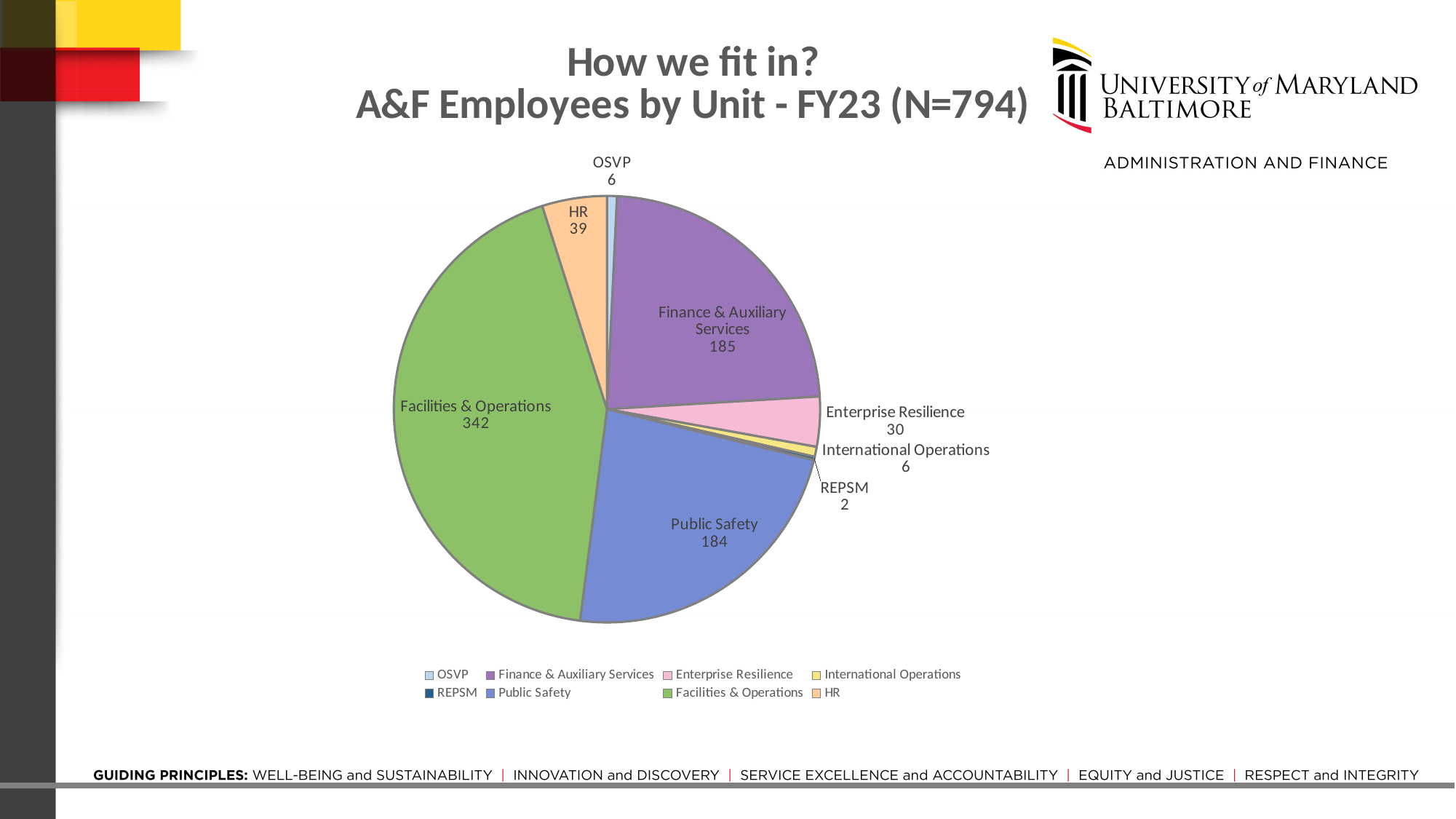
How many employees are in Facilities & Operations? 342 What is the difference in employees between Facilities & Operations and Public Safety? 158 How many employees are in HR? 39 How many units are shown in the pie chart? 8 What type of chart is shown on the slide? Pie chart Which unit has the smallest number of employees? REPSM Which unit has the largest number of employees? Facilities & Operations What colour is the Facilities & Operations slice? Green How many employees are in Enterprise Resilience? 30 Which unit has more employees, Finance & Auxiliary Services or Public Safety? Finance & Auxiliary Services What is the total number of A&F employees shown in the chart title? 794 How many employees are in Finance & Auxiliary Services? 185